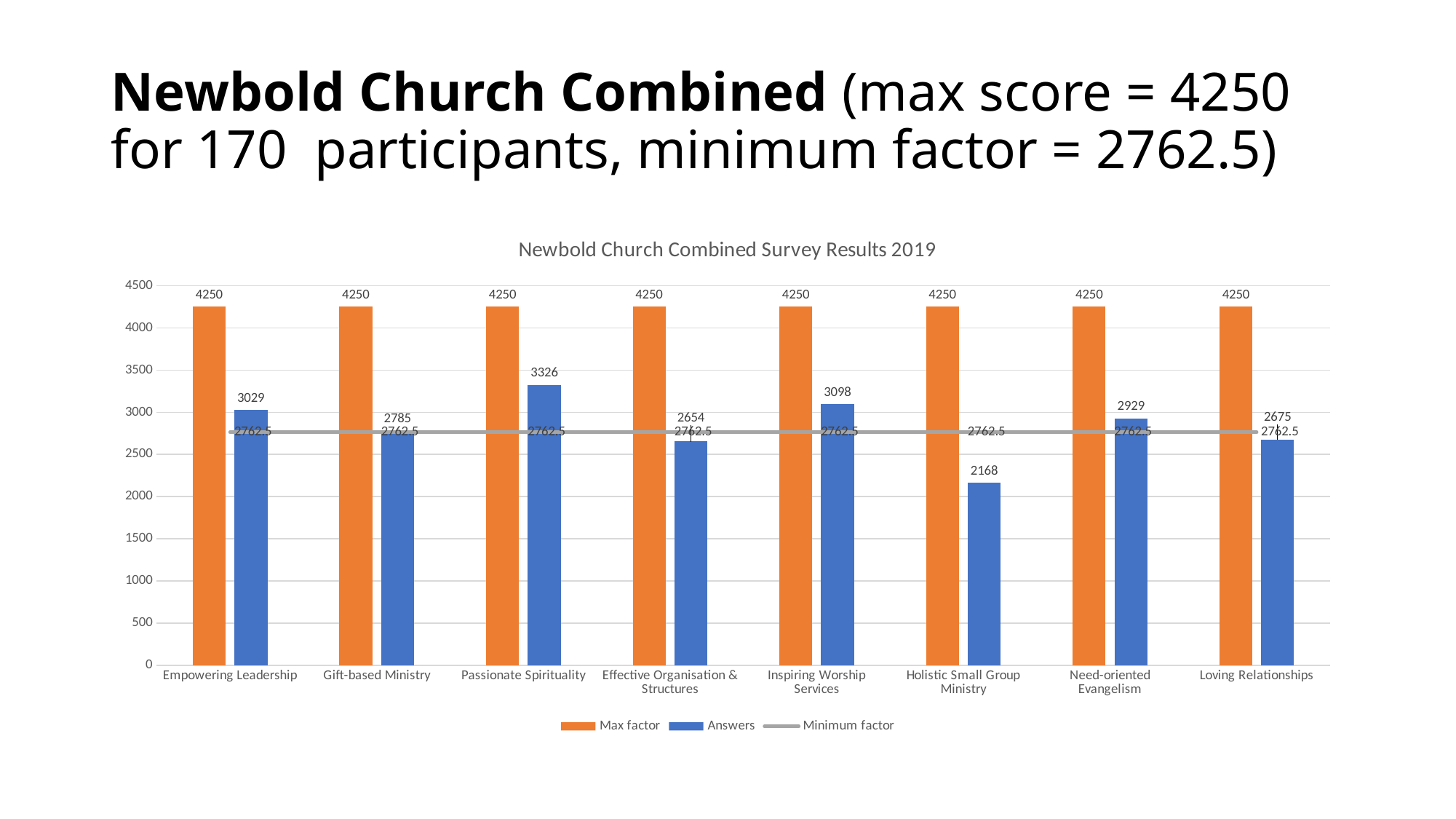
Which has a larger Answers value, Empowering Leadership or Inspiring Worship Services? Inspiring Worship Services What is the difference between the Answers values for Passionate Spirituality and Holistic Small Group Ministry? 1158 How many series does the legend list? 3 What is the Answers value for Passionate Spirituality? 3326 What is the title of the chart? Newbold Church Combined Survey Results 2019 Which category has the highest Answers value? Passionate Spirituality Is the Answers value for Effective Organisation & Structures greater or less than 3000? less What is the Answers value for Holistic Small Group Ministry? 2168 What kind of chart is this? combination bar and line chart What is the Answers value for Need-oriented Evangelism? 2929 How many categories are shown on the x axis? 8 Which category has the lowest Answers value? Holistic Small Group Ministry